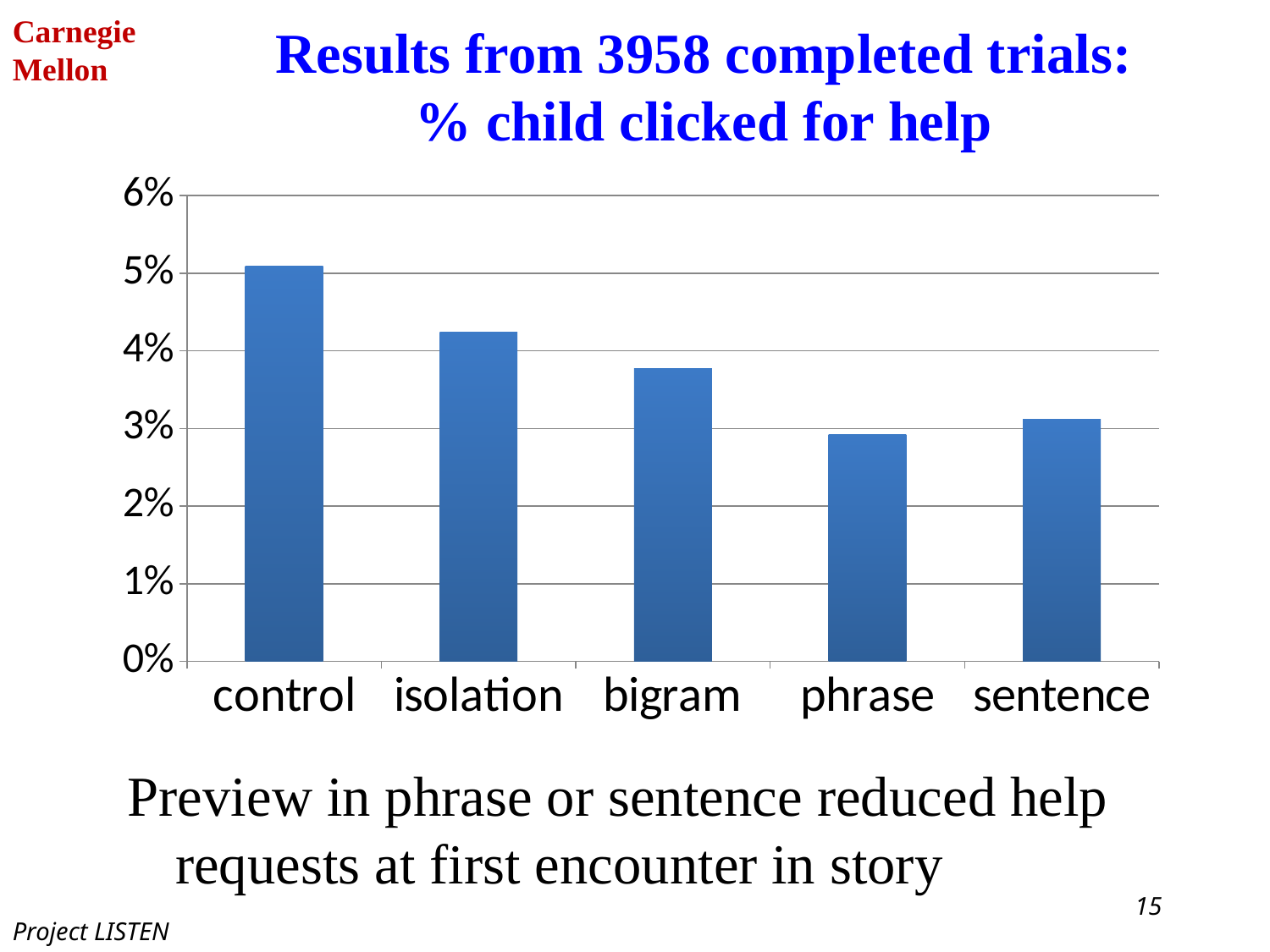
Which has a larger value, control or isolation? control How many categories are shown on the x axis of the chart? 5 Is the value for bigram greater or less than 4%? less What kind of chart is shown on the slide? bar chart Which category has the lowest value in the chart? phrase Which category has the highest value in the chart? control Is the value for isolation greater or less than 4%? greater Is the value for sentence greater or less than 4%? less Which has a larger value, bigram or phrase? bigram Do the values generally rise or fall from control to phrase along the x axis? fall